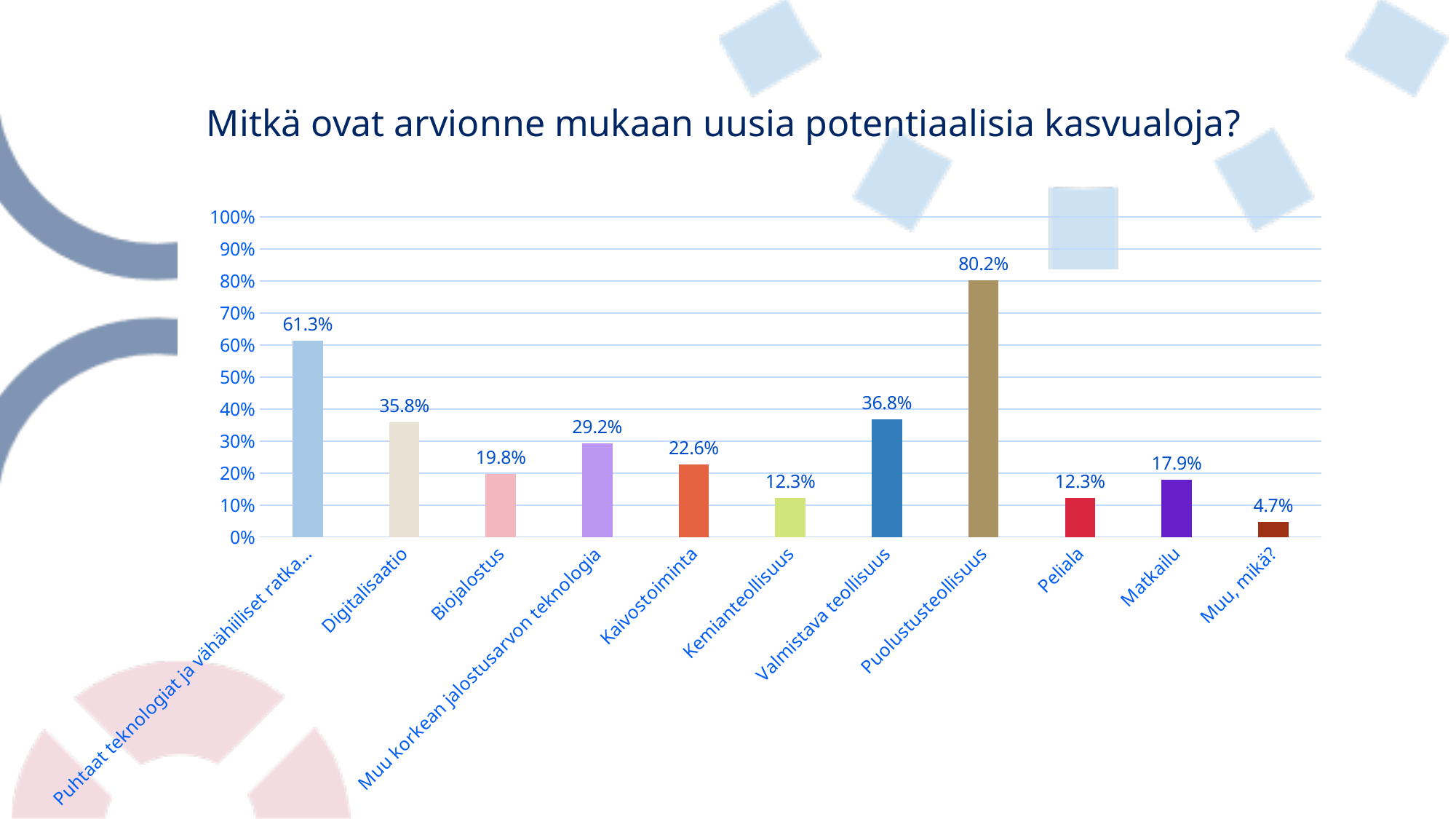
What is the value for Puolustusteollisuus? 80.2% Which is larger, the value for Biojalostus or the value for Muu korkean jalostusarvon teknologia? Muu korkean jalostusarvon teknologia How many categories are shown on the x axis? 11 Which category has the lowest value? Muu, mikä? What is the title of the chart? Mitkä ovat arvionne mukaan uusia potentiaalisia kasvualoja? What is the value for Digitalisaatio? 35.8% What is the value for Kaivostoiminta? 22.6% What kind of chart is shown on the slide? bar chart What is the difference between the values for Puolustusteollisuus and Valmistava teollisuus? 43.4% Which category has the highest value? Puolustusteollisuus Is the value for Valmistava teollisuus greater or less than 30%? greater What is the value for Matkailu? 17.9%